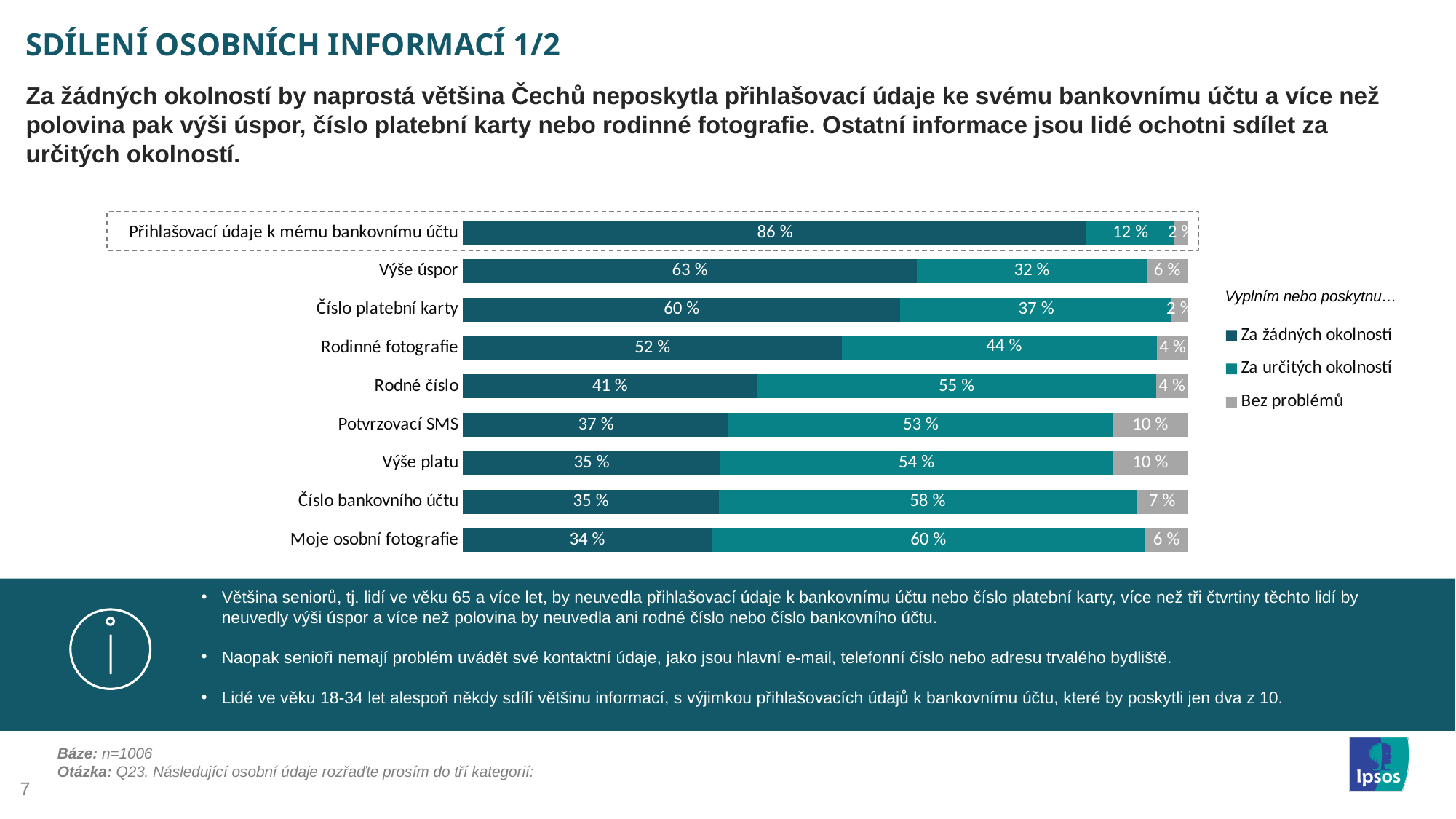
How many series does the chart legend list? 3 How many categories (personal information items) are plotted in the chart? 9 What is the 'Bez problémů' value for 'Potvrzovací SMS'? 10 % What is the total of the three segments for the 'Rodinné fotografie' bar? 100 % What is the difference between the 'Za žádných okolností' values for 'Výše úspor' and 'Číslo platební karty'? 3 % What type of chart is shown on the slide? Stacked bar chart Which category has the highest 'Za žádných okolností' value? Přihlašovací údaje k mému bankovnímu účtu Which category has the lowest 'Za žádných okolností' value? Moje osobní fotografie Which is larger: the 'Za určitých okolností' value for 'Číslo bankovního účtu' or for 'Výše platu'? Číslo bankovního účtu What is the 'Za žádných okolností' value for 'Výše úspor'? 63 % What is the 'Za určitých okolností' value for 'Rodné číslo'? 55 % Which legend entry is shown in grey? Bez problémů